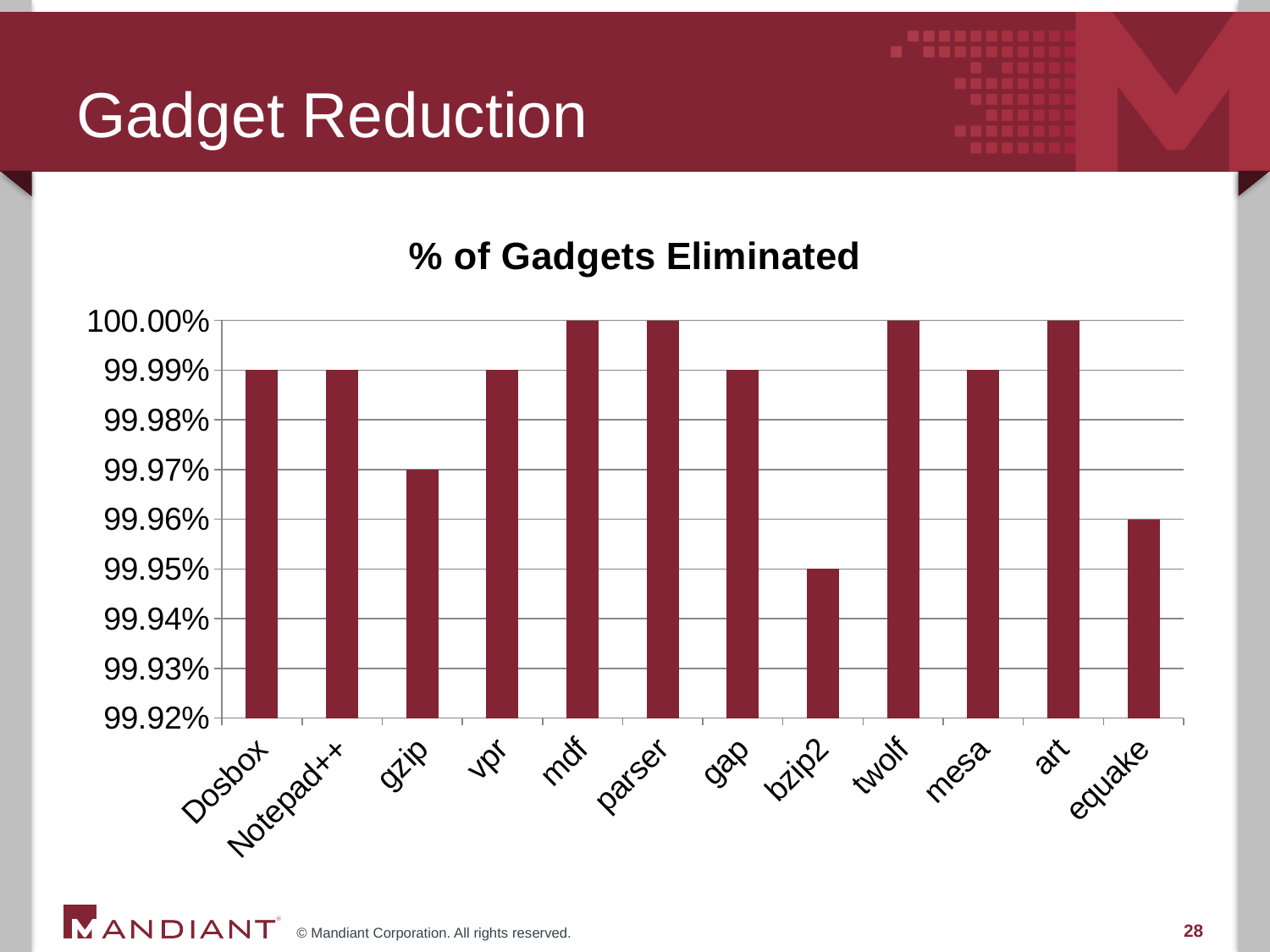
How many categories are plotted on the x axis? 12 What is the title of the chart? % of Gadgets Eliminated What kind of chart is shown on the slide? bar chart What is the value for Dosbox? 99.99% Is the value for bzip2 greater or less than 99.96%? less What is the value for bzip2? 99.95% What is the difference between the values for gzip and bzip2? 0.02% What is the value for equake? 99.96% Which is larger, the value for equake or the value for bzip2? equake Which category has the lowest value? bzip2 What is the value for mdf? 100.00% What is the value for gzip? 99.97%